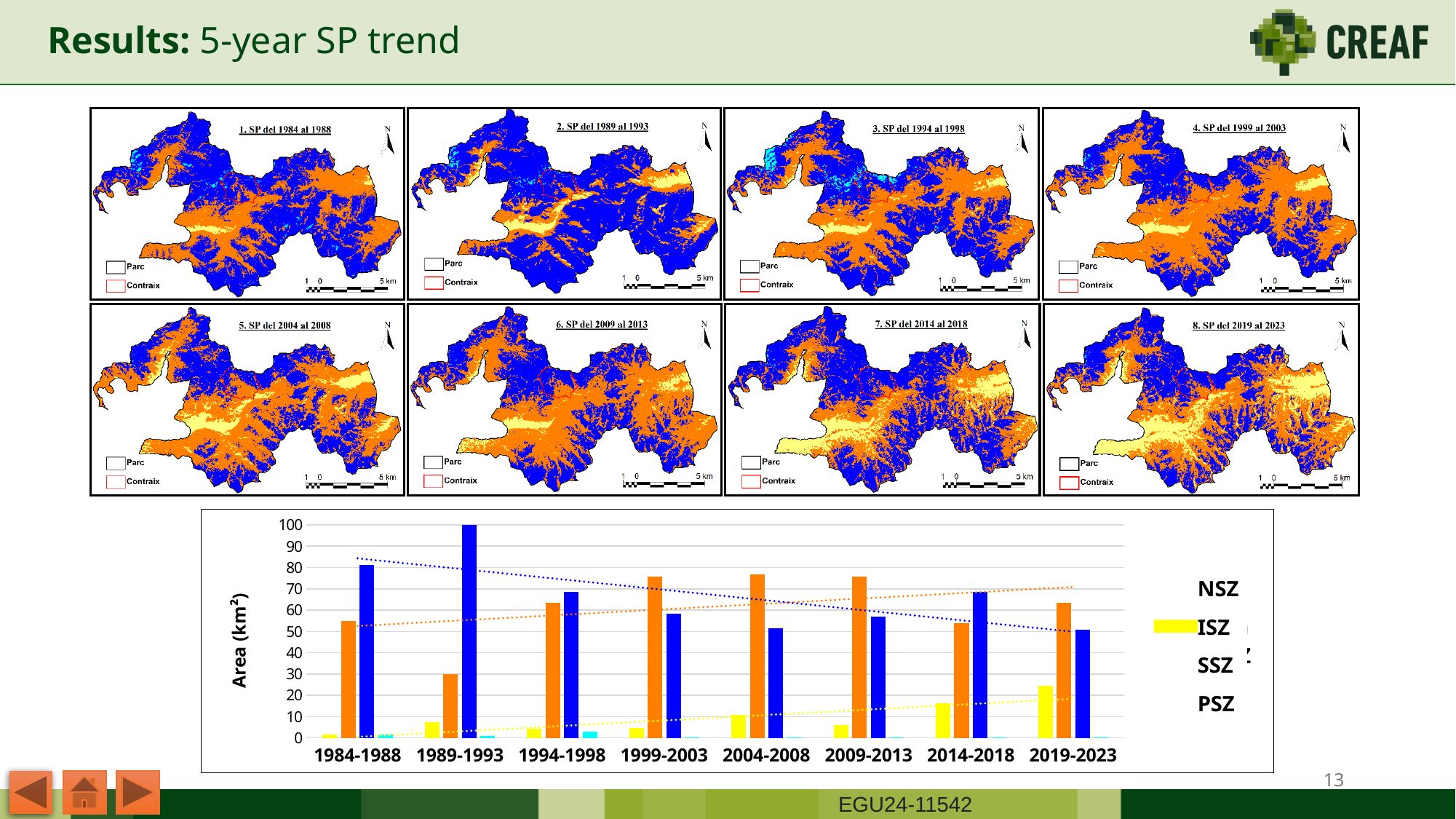
Does the blue dotted trend line rise or fall from 1984-1988 to 2019-2023? fall What kind of chart is shown at the bottom of the slide? bar chart Is the yellow bar for 2019-2023 greater or less than 20? greater In which period is the blue bar the tallest? 1989-1993 How many series does the legend of the bar chart list? 4 Which legend entry in the bar chart is shown with a yellow swatch? ISZ In which period is the yellow bar the tallest? 2019-2023 Is the blue bar for 1989-1993 greater or less than 90? greater What is the label of the y axis of the bar chart? Area (km²) Is the orange bar for 1989-1993 greater or less than 40? less How many 5-year periods are shown on the x axis of the bar chart? 8 In 1984-1988, which is larger, the orange bar or the blue bar? the blue bar